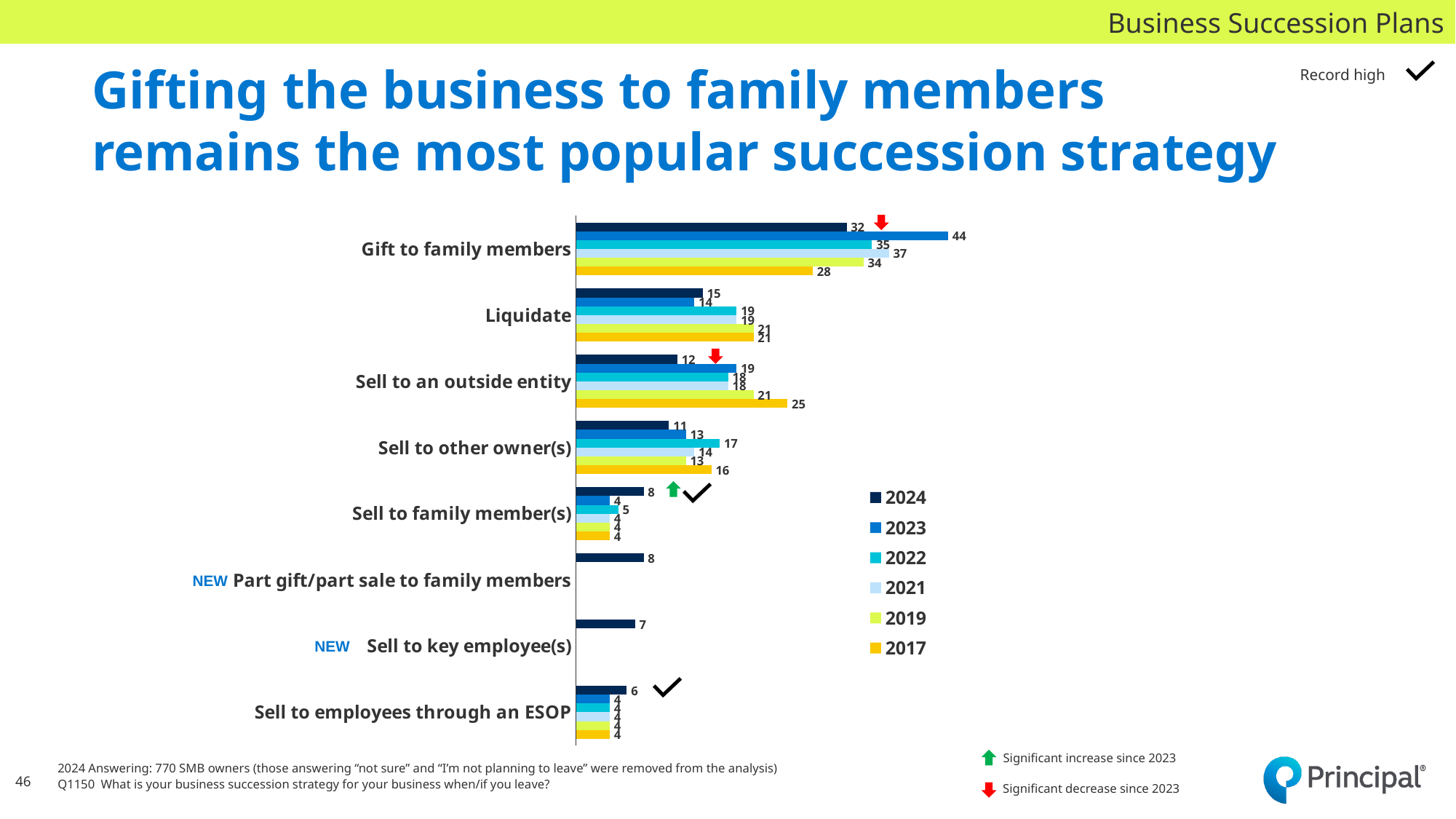
What is the difference between the 2023 and 2024 values for Gift to family members? 12 Which two categories are marked as NEW on the chart? Part gift/part sale to family members and Sell to key employee(s) How many categories are shown on the chart? 8 How many series does the legend list? 6 What kind of chart is shown on the slide? Bar chart What is the 2024 value for Sell to key employee(s)? 7 Which category has the highest 2024 value? Gift to family members What is the 2023 value for Gift to family members? 44 Which is larger for Liquidate: the 2024 value or the 2019 value? 2019 What is the 2017 value for Sell to an outside entity? 25 What is the 2024 value for Gift to family members? 32 Which category has the lowest 2024 value? Sell to employees through an ESOP